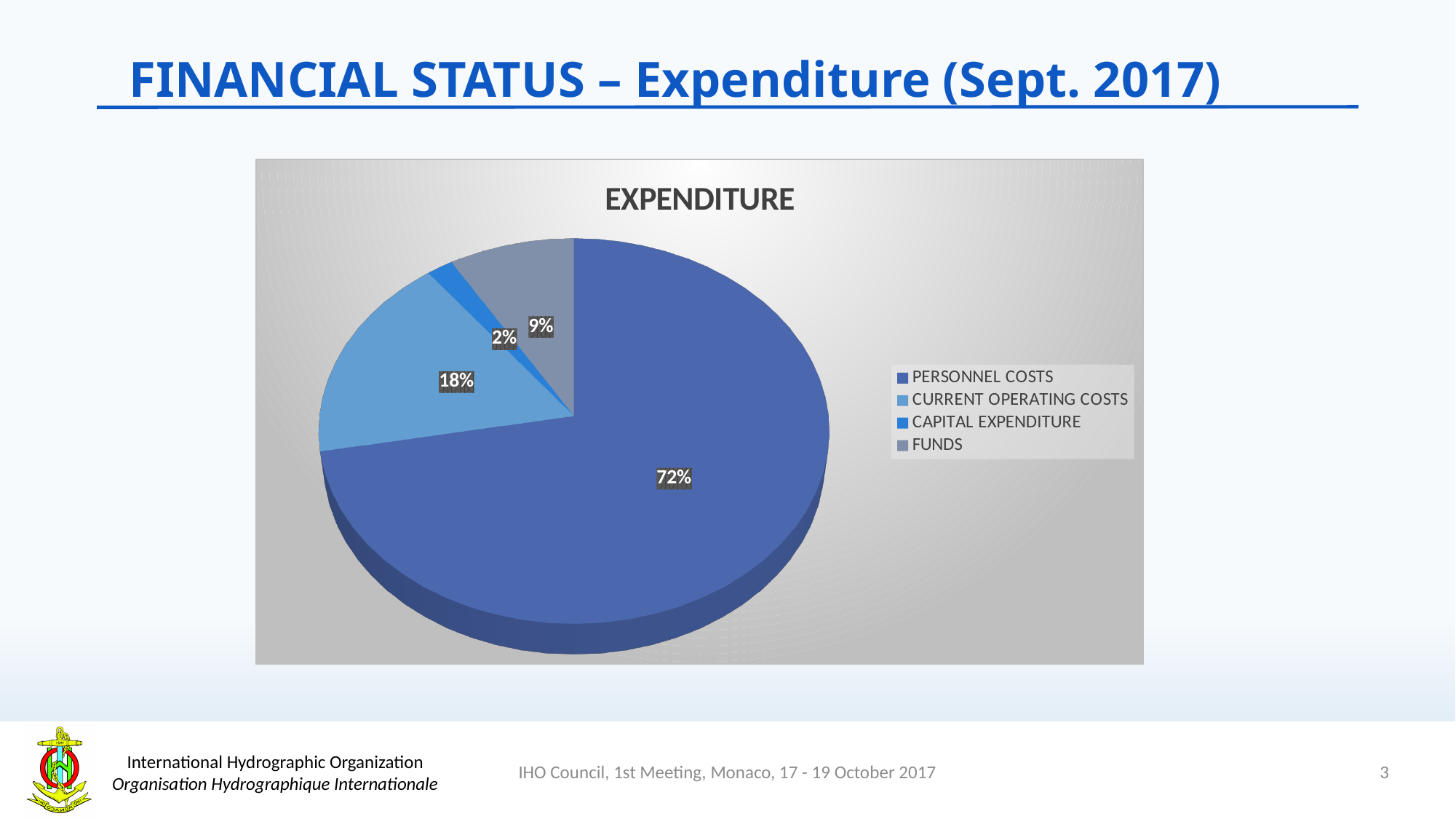
How many entries are listed in the legend? 4 What is the title of the chart? EXPENDITURE What type of chart is shown on the slide? Pie chart What share of expenditure is Capital Expenditure? 2% What share of expenditure is Funds? 9% What is the difference in percentage points between Personnel Costs and Current Operating Costs? 54 What share of expenditure is Personnel Costs? 72% Which is larger, the share for Funds or the share for Capital Expenditure? FUNDS How many categories does the pie chart show? 4 Which category has the largest share of expenditure? PERSONNEL COSTS Which category has the smallest share of expenditure? CAPITAL EXPENDITURE